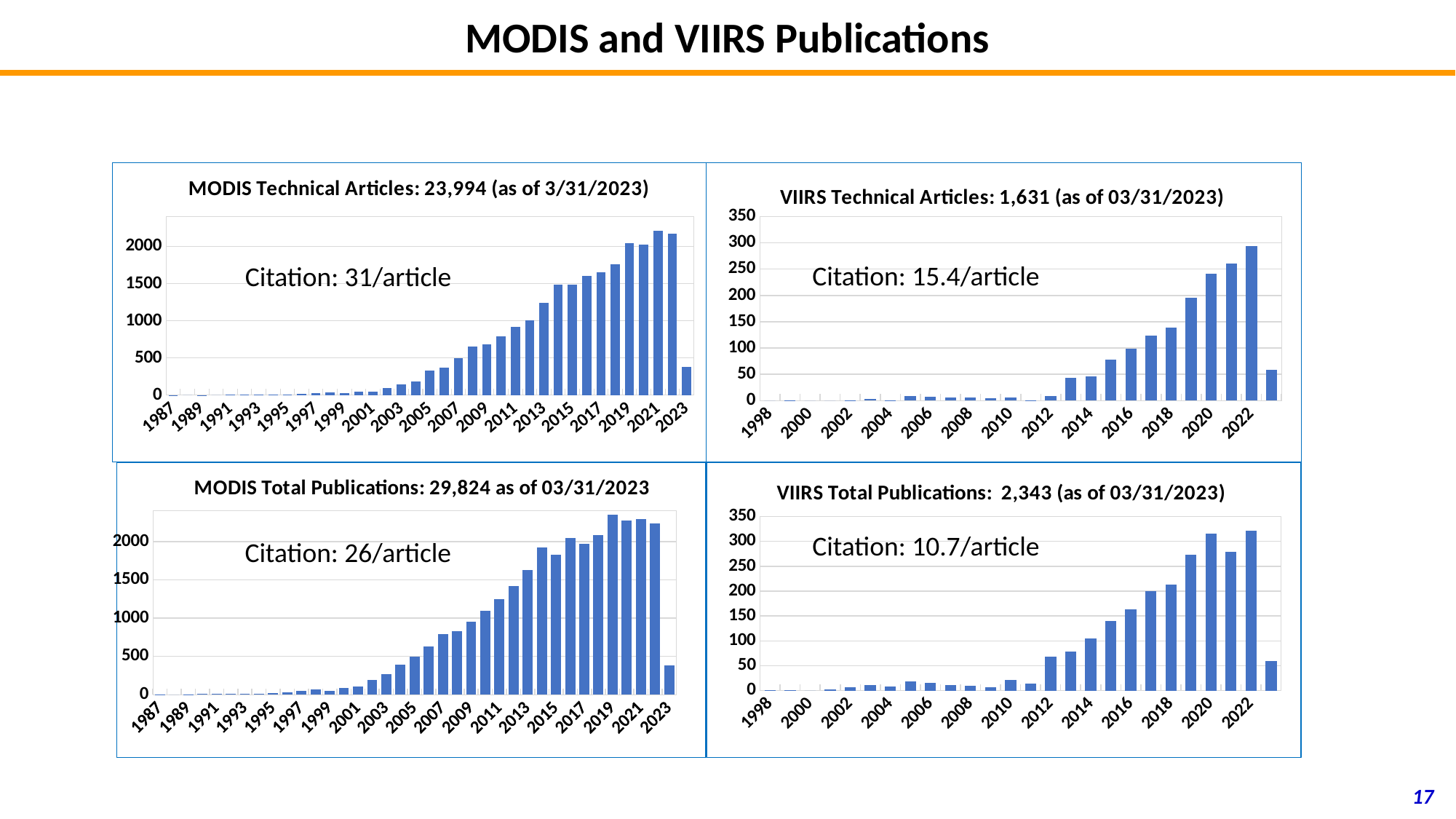
In the MODIS Technical Articles chart, is the value for 2021 greater or less than 2000? greater In the VIIRS Total Publications chart, is the value for 2019 greater or less than 250? greater In the MODIS Technical Articles chart, is the value for 2013 larger than the value for 2009? yes In the VIIRS Total Publications chart, is the value for 2016 greater or less than 150? greater What kind of chart is the MODIS Technical Articles chart? bar chart In the VIIRS Technical Articles chart, which year has the highest bar? 2022 In the MODIS Technical Articles chart, do the values generally rise or fall from 1987 to 2021? rise In the MODIS Total Publications chart, which year has the highest bar? 2019 What citation rate is printed on the VIIRS Total Publications chart? 10.7/article